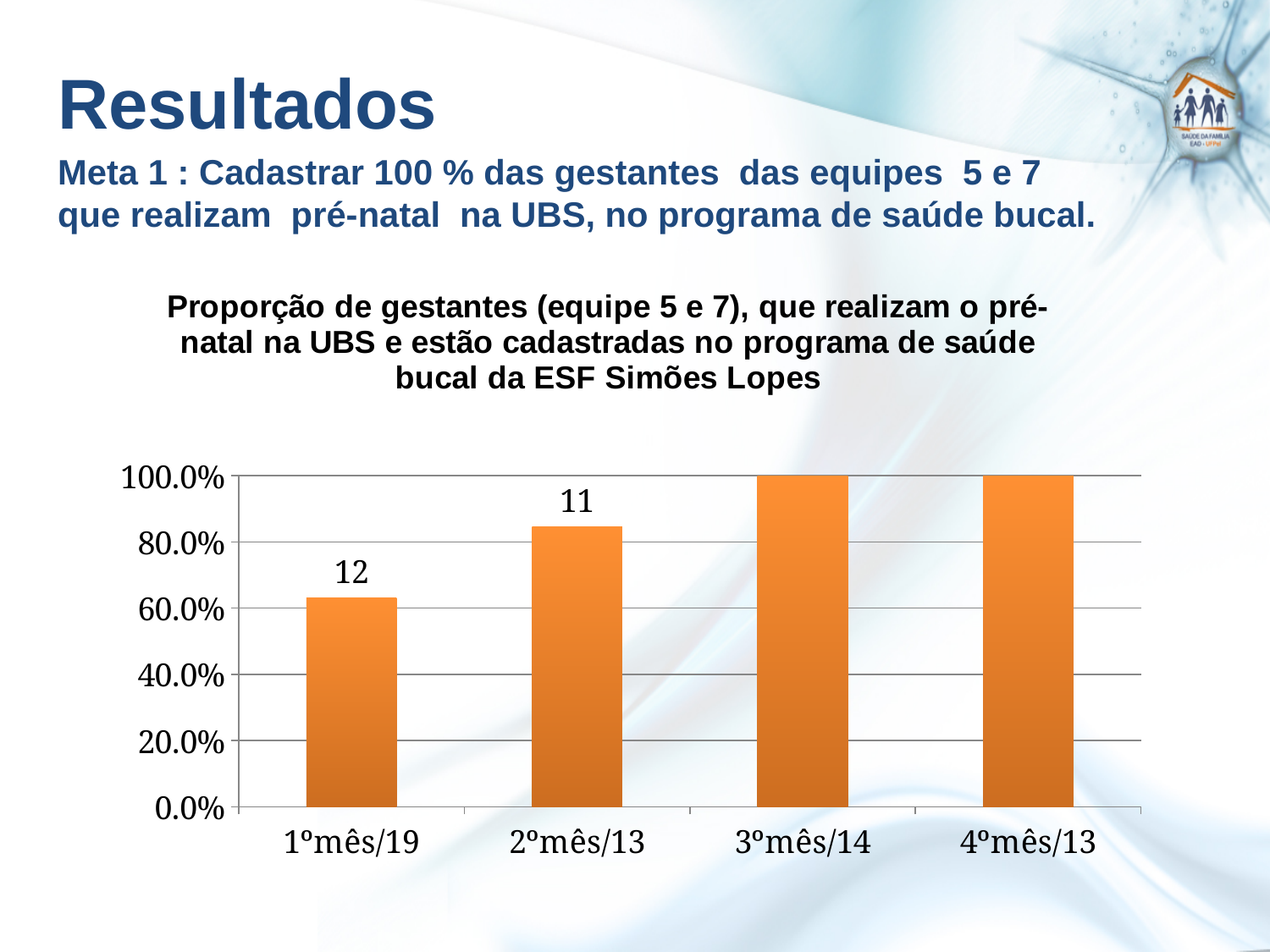
What proportion does the bar for 3ºmês/14 reach on the y axis? 100.0% Is the value for 2ºmês/13 greater or less than 80.0%? greater Do the bar values rise or fall from 1ºmês/19 to 4ºmês/13? rise What data label is printed above the bar for 1ºmês/19? 12 What proportion does the bar for 4ºmês/13 reach on the y axis? 100.0% Which category has the lowest bar in the chart? 1ºmês/19 What kind of chart is shown on the slide? bar chart Is the value for 1ºmês/19 greater or less than 40.0%? greater Which bar is taller, 1ºmês/19 or 2ºmês/13? 2ºmês/13 Is the value for 1ºmês/19 greater or less than 80.0%? less What data label is printed above the bar for 2ºmês/13? 11 How many categories are shown on the x axis of the chart? 4